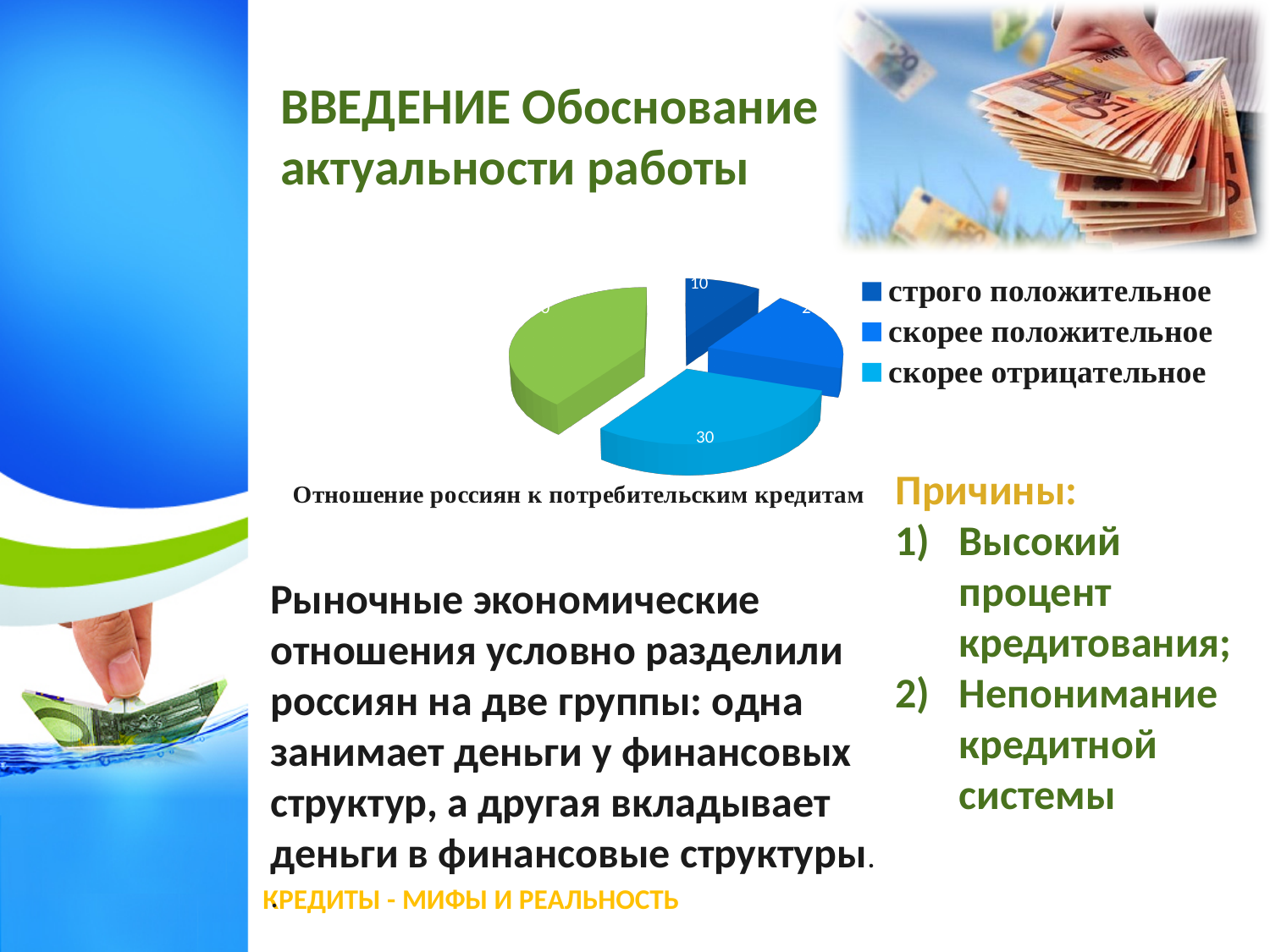
What is the difference between the values for "скорее отрицательное" and "строго положительное"? 20 What kind of chart is shown on the slide? pie chart Which slice of the pie is the smallest? строго положительное How many entries does the chart legend list? 3 What is the title of the chart? Отношение россиян к потребительским кредитам Which is larger, "скорее отрицательное" or "строго положительное"? скорее отрицательное What value is shown for the slice "скорее отрицательное"? 30 What value is shown for the slice "строго положительное"? 10 How many slices does the pie chart have? 4 What colour is used for "строго положительное" in the legend? dark blue